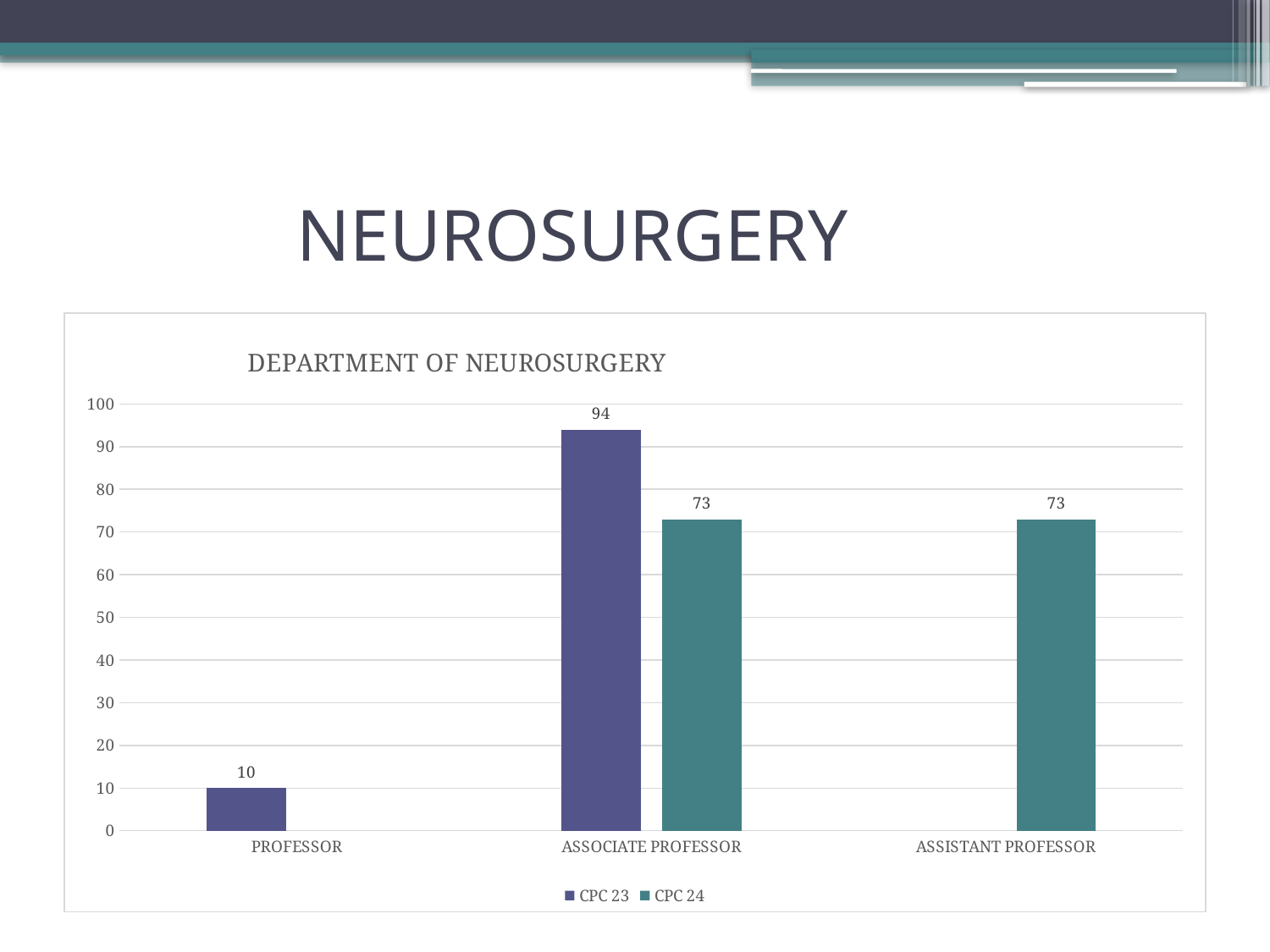
What is the CPC 23 value for PROFESSOR? 10 Is the CPC 23 value for ASSOCIATE PROFESSOR greater or less than 90? greater What is the CPC 24 value for ASSOCIATE PROFESSOR? 73 What is the CPC 24 value for ASSISTANT PROFESSOR? 73 Which is larger for ASSOCIATE PROFESSOR, the CPC 23 value or the CPC 24 value? CPC 23 Which category has the highest CPC 23 value? ASSOCIATE PROFESSOR Which category has the lowest CPC 23 value? PROFESSOR How many categories are shown on the x axis? 3 What is the difference between the CPC 23 and CPC 24 values for ASSOCIATE PROFESSOR? 21 What is the CPC 23 value for ASSOCIATE PROFESSOR? 94 What kind of chart is shown on the slide? bar chart How many series does the legend list? 2